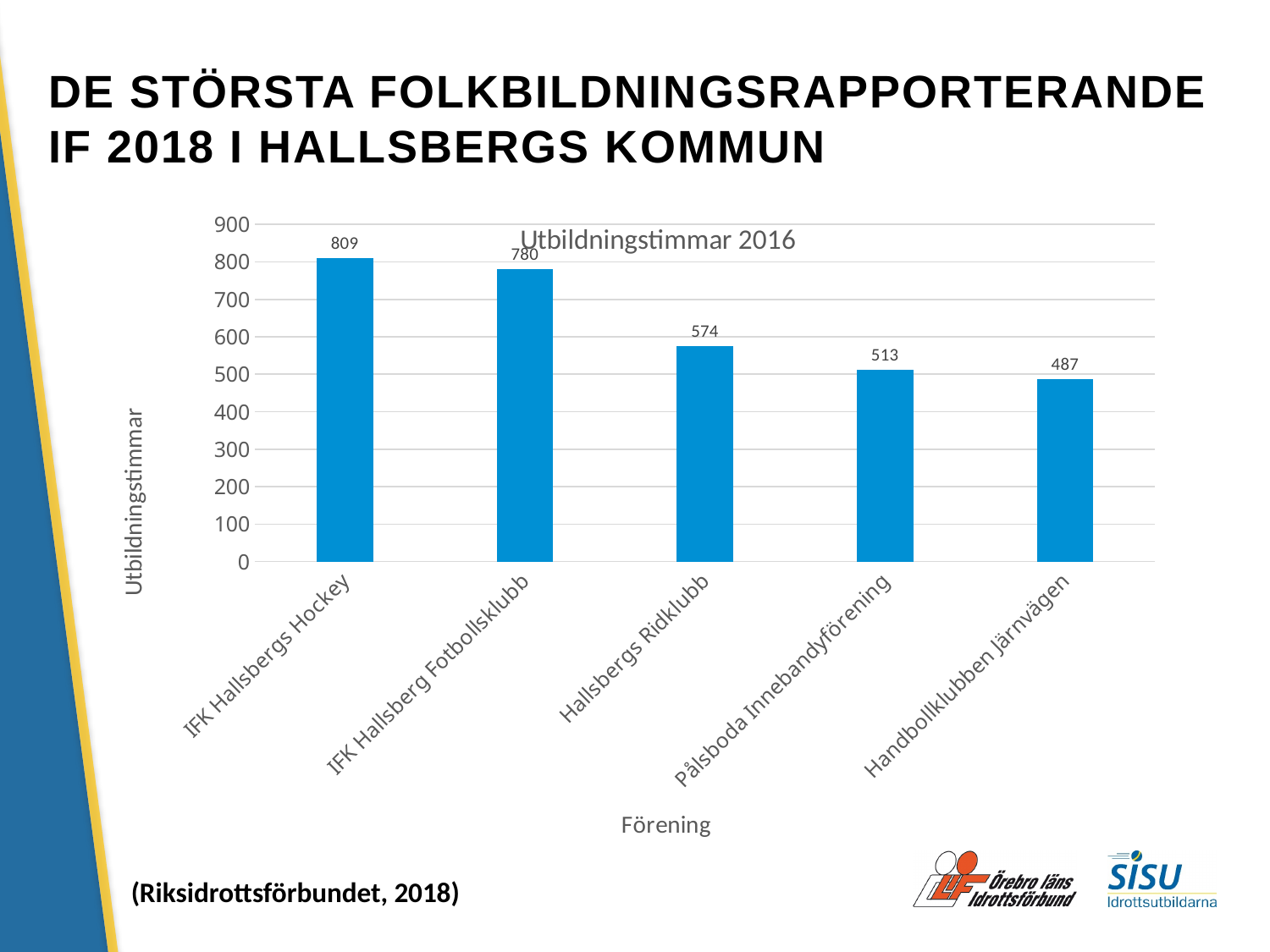
Which is larger, the value for Pålsboda Innebandyförening or the value for Handbollklubben Järnvägen? Pålsboda Innebandyförening What is the value for Handbollklubben Järnvägen? 487 Which förening has the lowest number of utbildningstimmar? Handbollklubben Järnvägen What is the difference between the values for Hallsbergs Ridklubb and Pålsboda Innebandyförening? 61 What is the difference between the values for IFK Hallsbergs Hockey and IFK Hallsberg Fotbollsklubb? 29 What is the title of the chart? Utbildningstimmar 2016 What is the value for IFK Hallsbergs Hockey? 809 Which förening has the highest number of utbildningstimmar? IFK Hallsbergs Hockey Is the value for IFK Hallsberg Fotbollsklubb greater or less than 700? greater What is the value for Hallsbergs Ridklubb? 574 What kind of chart is shown on the slide? bar chart How many föreningar are shown in the chart? 5